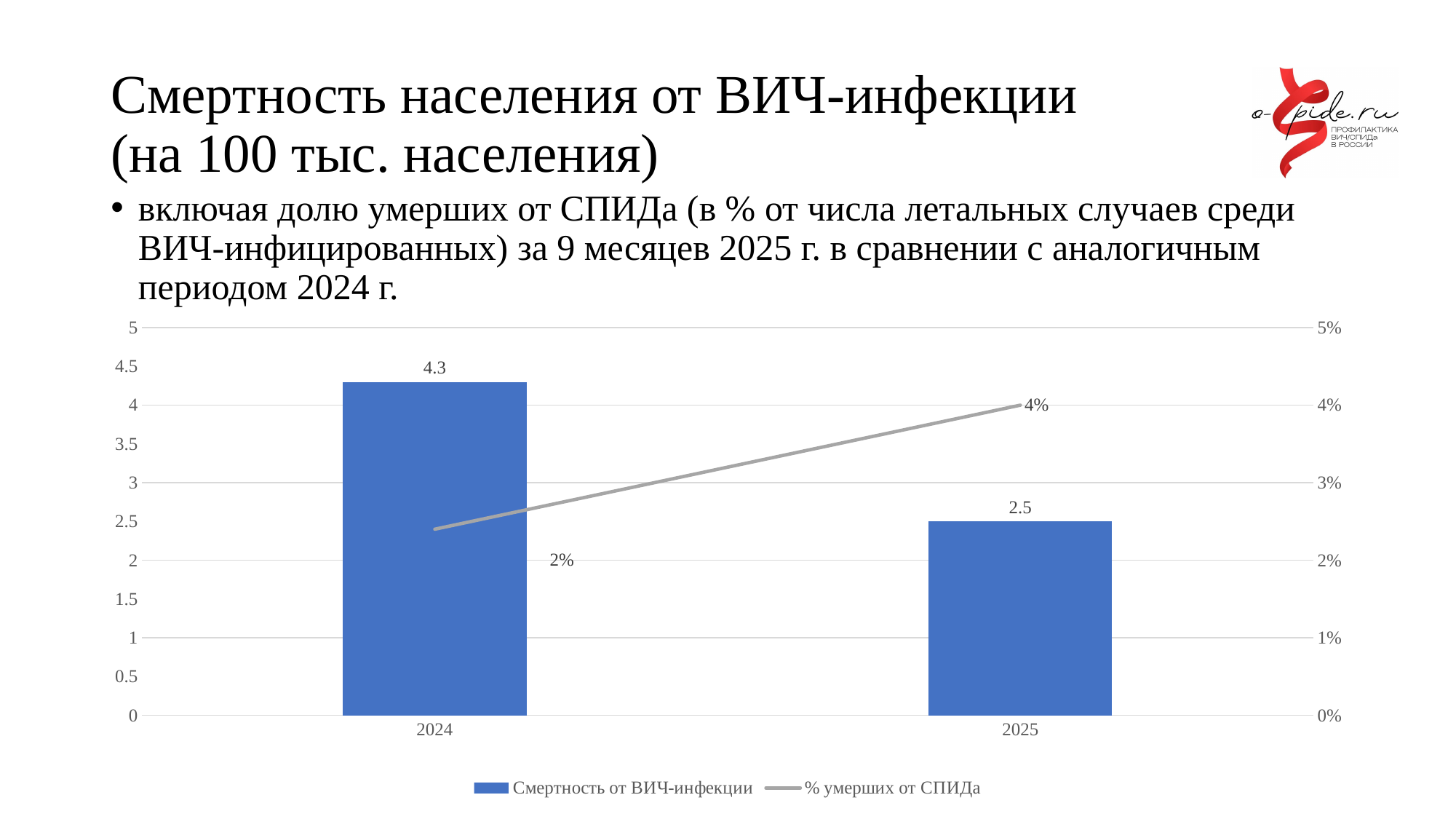
What is the value of "Смертность от ВИЧ-инфекции" for 2025? 2.5 Which year has the higher value for "Смертность от ВИЧ-инфекции"? 2024 What is the value of "% умерших от СПИДа" for 2024? 2% How many series does the legend list? 2 How many years are shown on the x axis? 2 Is the "% умерших от СПИДа" value for 2025 larger or smaller than the value for 2024? larger Does the "Смертность от ВИЧ-инфекции" series rise or fall from 2024 to 2025? fall What is the difference between the "Смертность от ВИЧ-инфекции" values for 2024 and 2025? 1.8 Which year has the lower value for "% умерших от СПИДа"? 2024 What is the value of "Смертность от ВИЧ-инфекции" for 2024? 4.3 What colour are the bars for "Смертность от ВИЧ-инфекции"? blue What is the value of "% умерших от СПИДа" for 2025? 4%